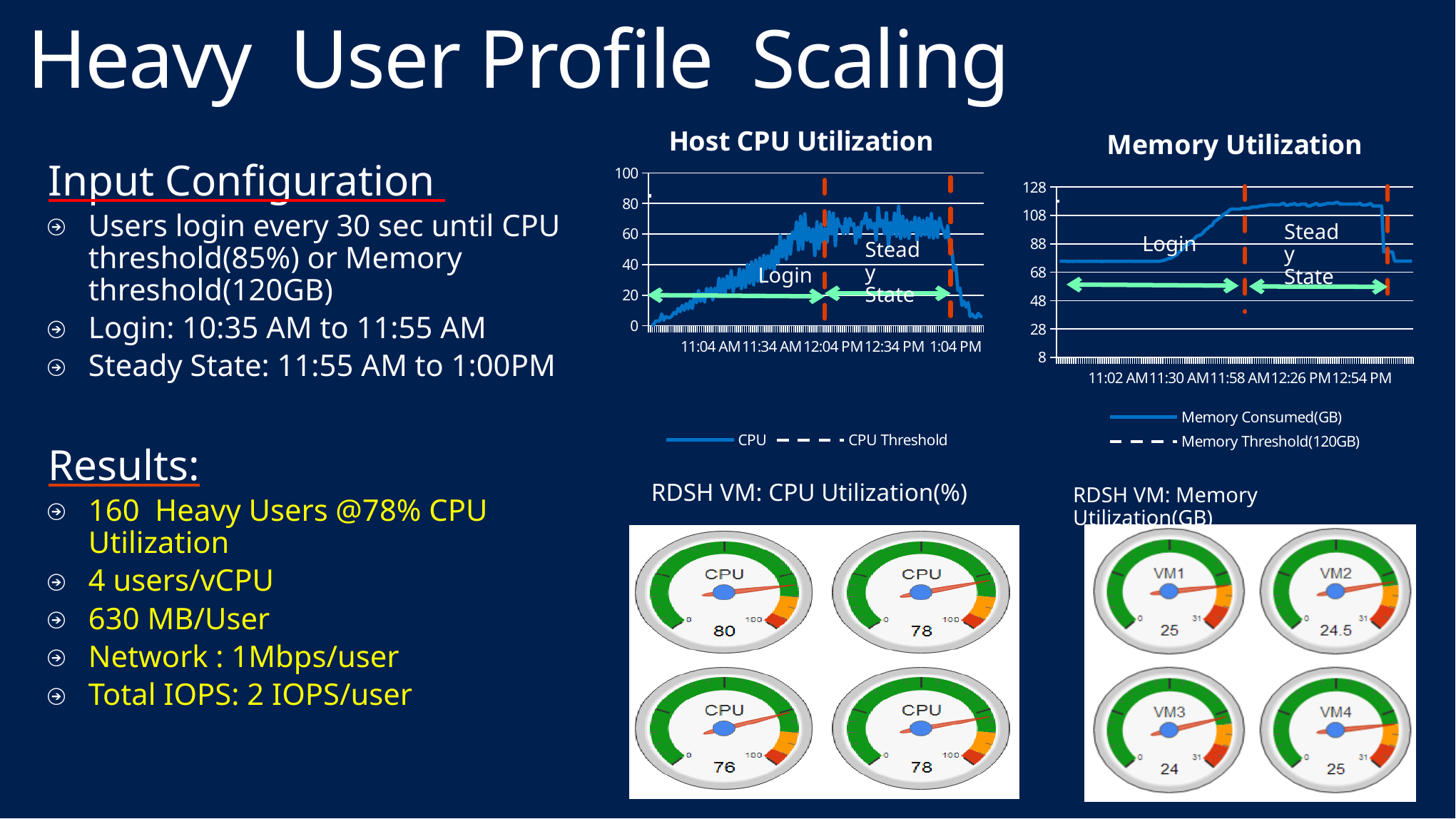
In the RDSH VM: Memory Utilization(GB) gauges, what is the difference between the values for VM1 and VM3? 1 What are the two legend entries of the Memory Utilization chart? Memory Consumed(GB) and Memory Threshold(120GB) In the RDSH VM: CPU Utilization(%) gauges, what is the lowest value shown? 76 In the RDSH VM: CPU Utilization(%) gauges, what is the highest value shown? 80 In the Memory Utilization chart, is the Memory Consumed value at 11:02 AM greater or less than 108? less In the Memory Utilization chart, is the Memory Consumed value at 12:26 PM greater or less than 108? greater What type of chart is the Host CPU Utilization chart? line chart How many series does the legend of the Host CPU Utilization chart list? 2 In the RDSH VM: Memory Utilization(GB) gauges, what is the value for VM2? 24.5 In the Host CPU Utilization chart, does the CPU line rise or fall during the Login period? rise In the Host CPU Utilization chart, is the CPU value at 12:34 PM greater or less than 40? greater